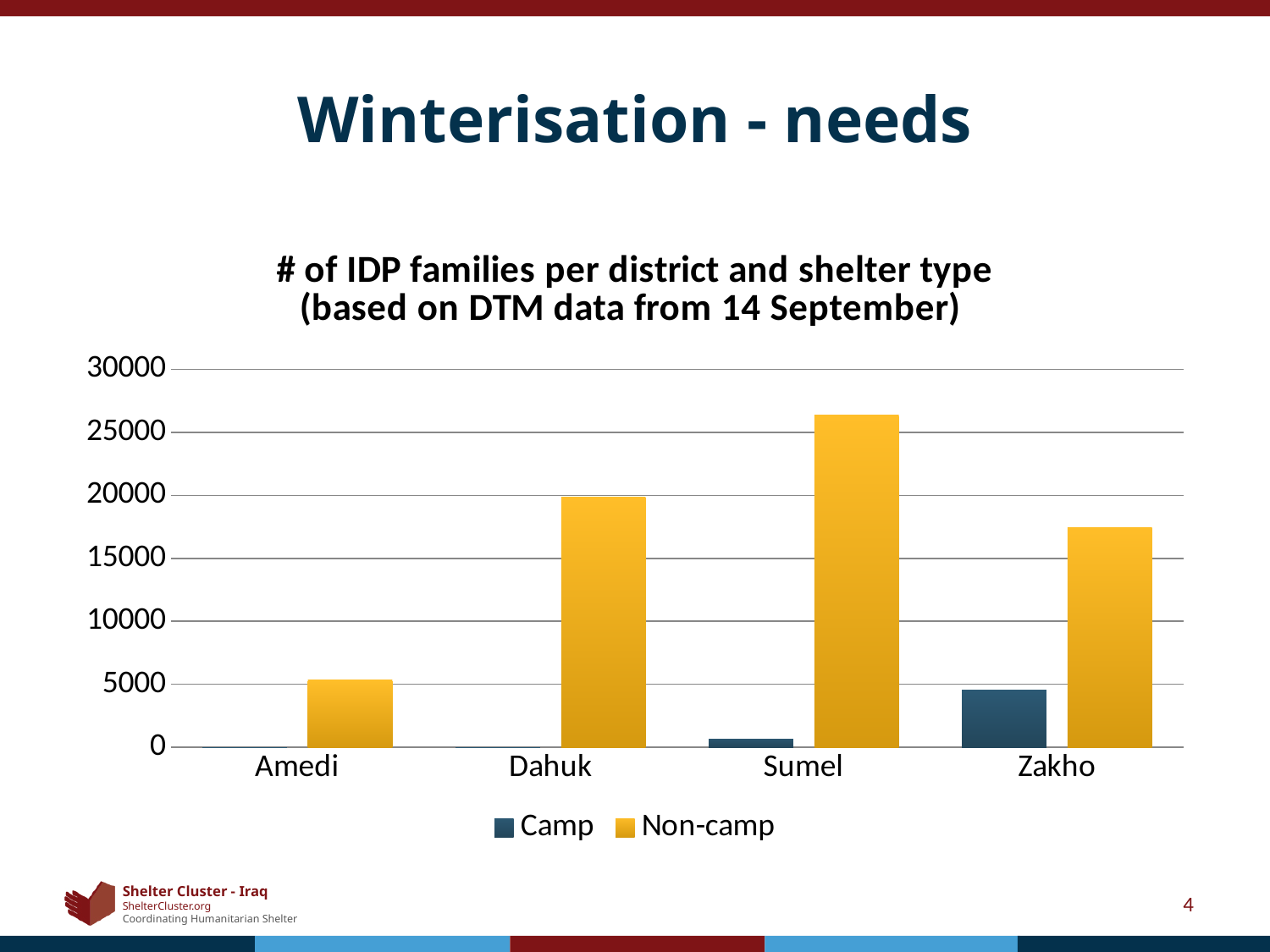
Which is larger, the Non-camp value for Dahuk or the Non-camp value for Zakho? Dahuk What kind of chart is shown on the slide? bar chart How many series does the chart's legend list? 2 How many districts are shown on the x axis of the chart? 4 Is the Camp value for Zakho greater or less than 5000? less Is the Non-camp value for Sumel greater or less than 25000? greater Which district has the lowest Non-camp value? Amedi Which colour represents the Non-camp series in the chart? yellow Which district has the highest Camp value? Zakho Which district has the highest Non-camp value? Sumel Is the Non-camp value for Zakho greater or less than 15000? greater